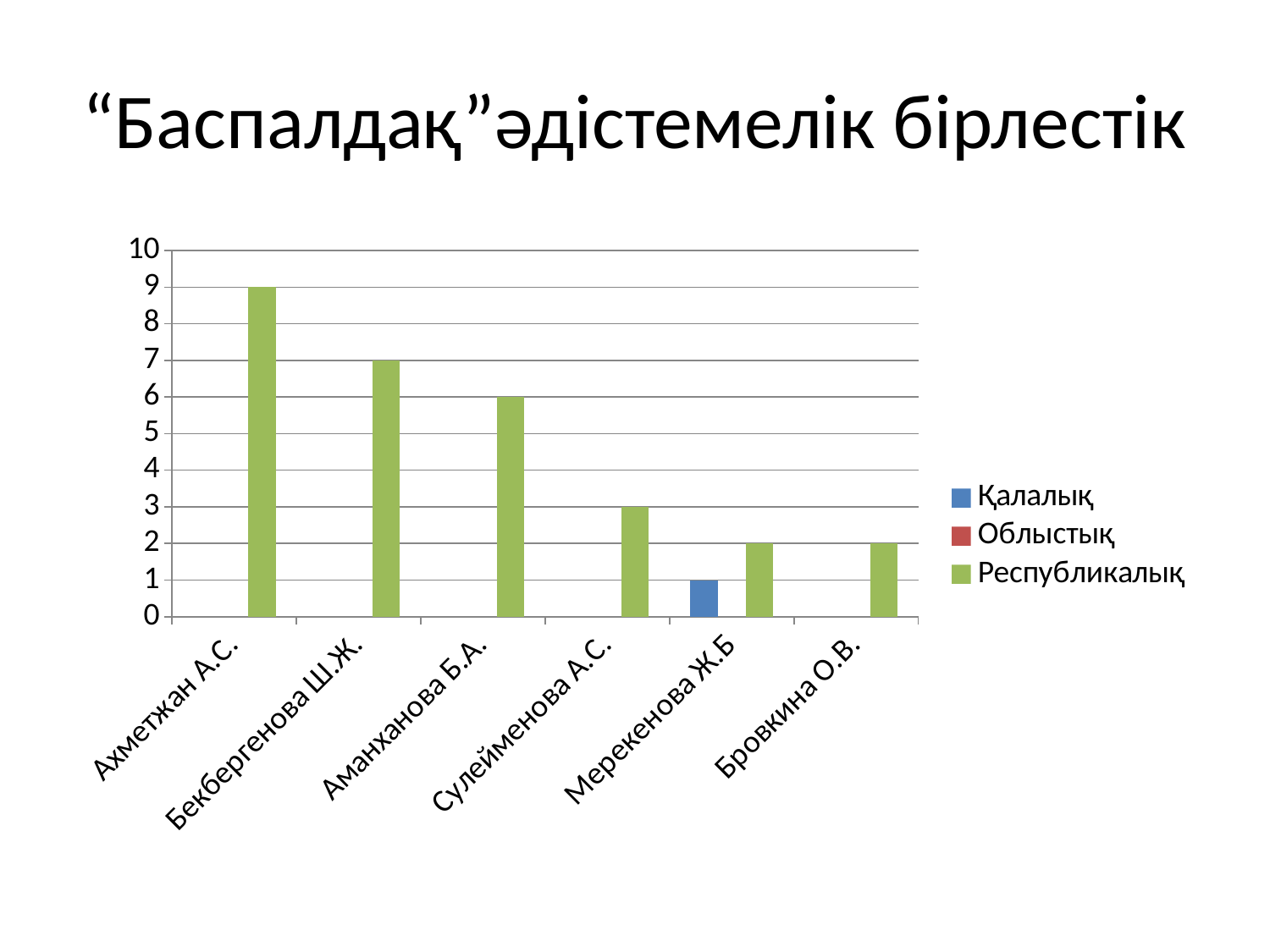
Do the Республикалық values generally rise or fall from left to right along the x axis? fall Which category has the highest Республикалық value? Ахметжан А.С. How many series does the legend list? 3 What is the Республикалық value for Ахметжан А.С.? 9 Which is larger, the Республикалық value for Бекбергенова Ш.Ж. or for Сулейменова А.С.? Бекбергенова Ш.Ж. What kind of chart is shown on the slide? bar chart How many categories (teachers) are shown on the x axis? 6 What is the Қалалық value for Мерекенова Ж.Б? 1 Which series is shown in green in the legend? Республикалық What is the Республикалық value for Бекбергенова Ш.Ж.? 7 What is the difference between the Республикалық values for Ахметжан А.С. and Аманханова Б.А.? 3 Is the Республикалық value for Аманханова Б.А. greater or less than 5? greater